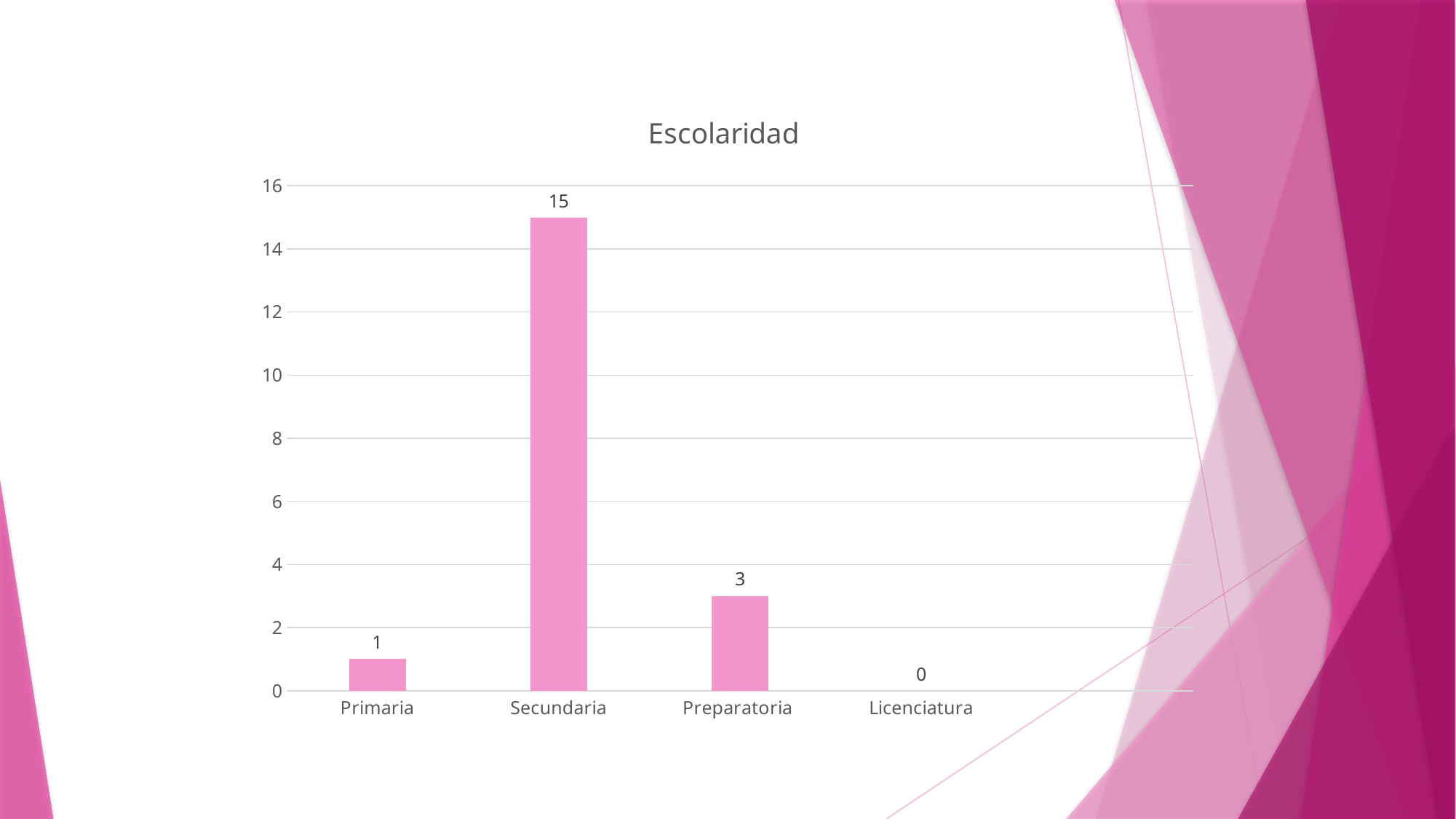
What is the value for Secundaria? 15 Which category has the highest value? Secundaria Which is larger, the value for Primaria or the value for Preparatoria? Preparatoria What is the value for Primaria? 1 What kind of chart is this? bar chart Is the value for Secundaria greater or less than 10? greater Which category has the lowest value? Licenciatura How many categories are shown on the x axis? 4 What is the difference between the values for Secundaria and Preparatoria? 12 What is the title of the chart? Escolaridad What is the value for Licenciatura? 0 What is the value for Preparatoria? 3